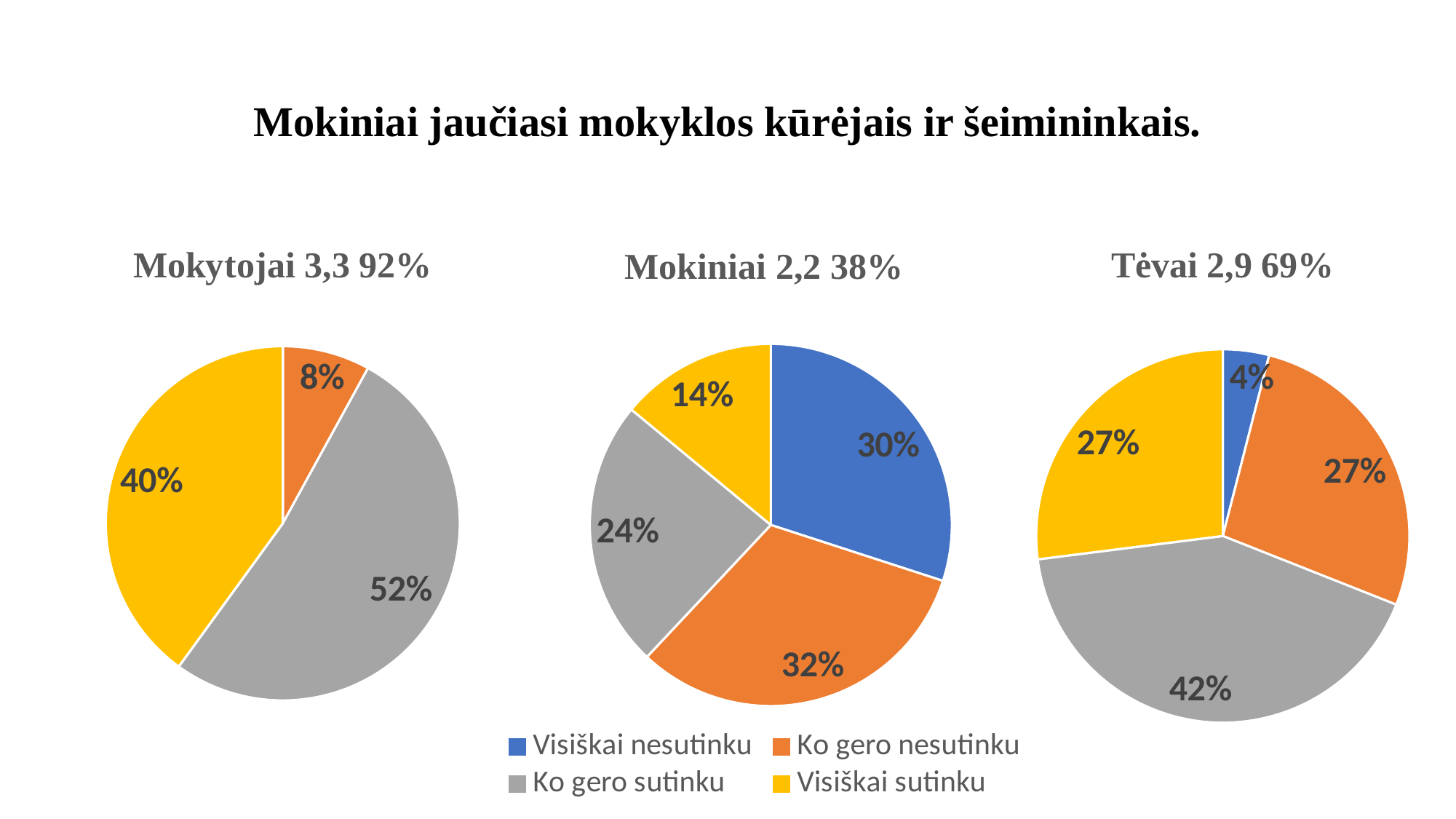
In the 'Mokytojai 3,3 92%' pie chart, which category has the smallest labelled slice? Ko gero nesutinku In the 'Mokiniai 2,2 38%' pie chart, which category has the smallest slice? Visiškai sutinku Which colour represents 'Visiškai sutinku' in the legend? Yellow In the 'Mokytojai 3,3 92%' pie chart, what share is labelled for 'Ko gero sutinku'? 52% What kind of chart is the 'Mokiniai 2,2 38%' chart? Pie chart How many series does the legend list? 4 In the 'Tėvai 2,9 69%' pie chart, what share is labelled for 'Ko gero sutinku'? 42% In the 'Mokiniai 2,2 38%' pie chart, which category has the largest slice? Ko gero nesutinku In the 'Tėvai 2,9 69%' pie chart, what share is labelled for 'Visiškai nesutinku'? 4% In the 'Tėvai 2,9 69%' pie chart, which is larger: 'Ko gero sutinku' or 'Ko gero nesutinku'? Ko gero sutinku In the 'Mokiniai 2,2 38%' pie chart, what share is labelled for 'Visiškai nesutinku'? 30% In the 'Mokytojai 3,3 92%' pie chart, what is the difference between the 'Ko gero sutinku' and 'Visiškai sutinku' shares? 12%